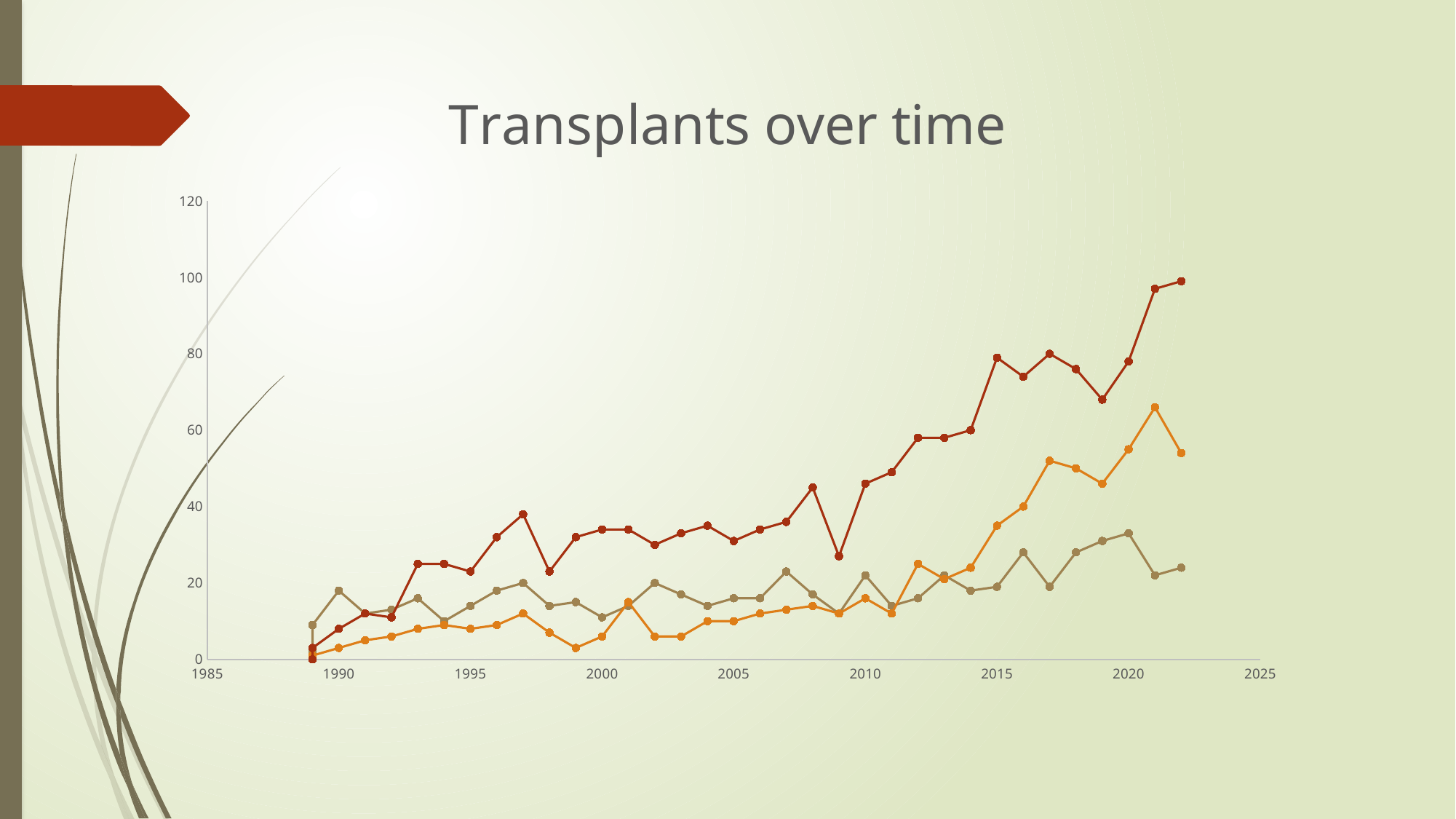
Overall, does the dark red line rise or fall from 1989 to 2022? rise Is the value of the dark red line in 2022 greater or less than 80? greater Is the value of the dark red line in 2009 greater or less than 40? less Is the value of the orange line in 2017 greater or less than 40? greater What is the title of the chart? Transplants over time What kind of chart is shown on the slide? line chart How many lines (series) are plotted on the chart? 3 Which line reaches the highest value on the chart? the dark red line Which line has the lowest value in 2022? the tan (grey-brown) line In 2022, is the dark red line or the orange line higher? the dark red line